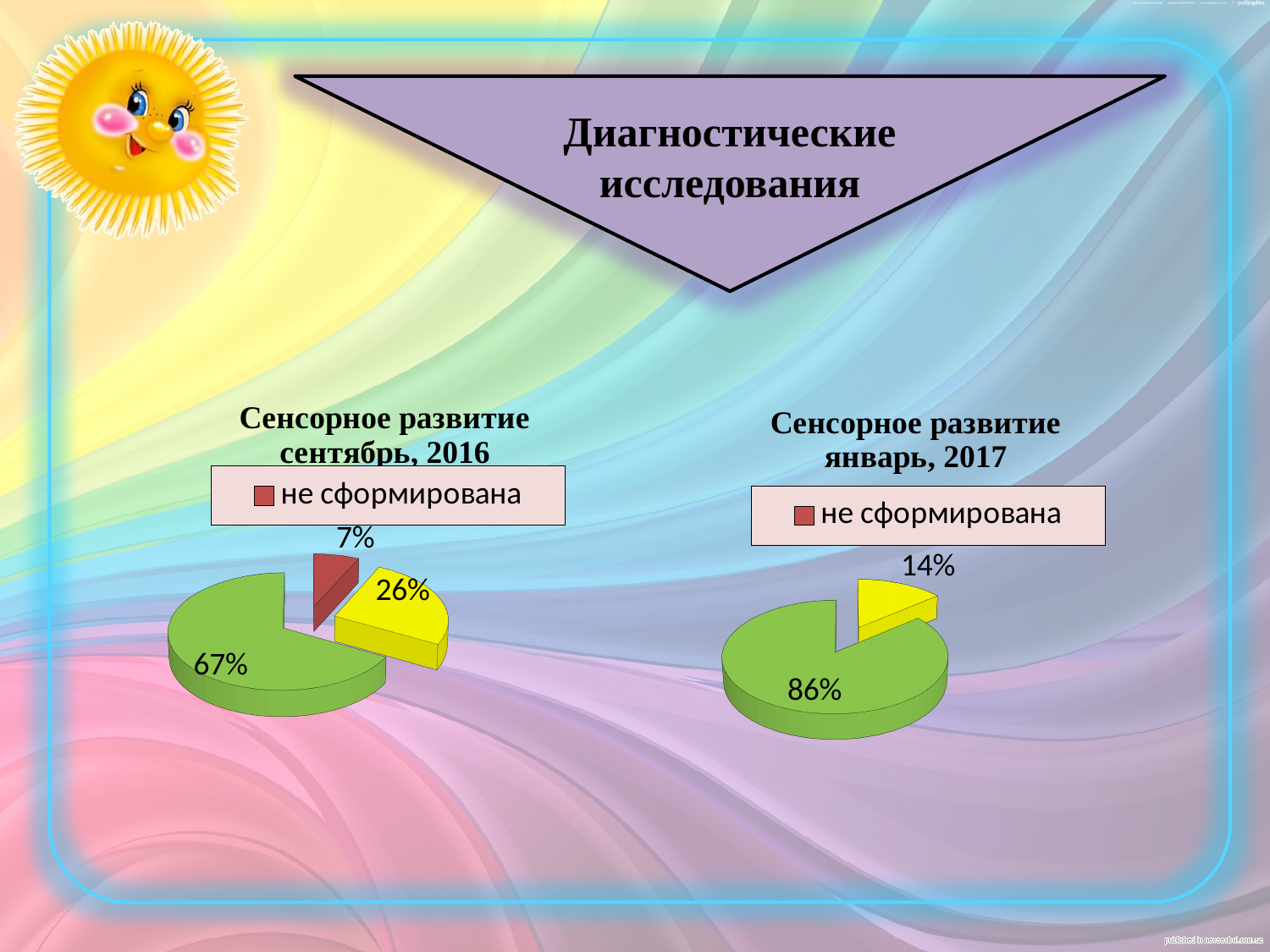
How many slices does the 'Сенсорное развитие январь, 2017' pie chart have? 2 In the 'Сенсорное развитие сентябрь, 2016' chart, what is the value of the largest slice? 67% Which is larger: the green slice in the 'Сенсорное развитие сентябрь, 2016' chart or the green slice in the 'Сенсорное развитие январь, 2017' chart? the green slice in the 'Сенсорное развитие январь, 2017' chart (86%) How many slices does the 'Сенсорное развитие сентябрь, 2016' pie chart have? 3 What kind of chart is the 'Сенсорное развитие сентябрь, 2016' chart? pie chart In the 'Сенсорное развитие сентябрь, 2016' chart, what is the difference between the largest slice (67%) and the yellow slice (26%)? 41 percentage points In the 'Сенсорное развитие сентябрь, 2016' chart, what is the value of the 'не сформирована' slice? 7% In the 'Сенсорное развитие январь, 2017' chart, what is the difference between the two slices? 72 percentage points In the 'Сенсорное развитие январь, 2017' chart, what is the value of the largest slice? 86% What legend entry is shown above the 'Сенсорное развитие сентябрь, 2016' chart? не сформирована In the 'Сенсорное развитие январь, 2017' chart, what is the value of the smallest slice? 14% In the 'Сенсорное развитие сентябрь, 2016' chart, what is the value of the smallest slice? 7%